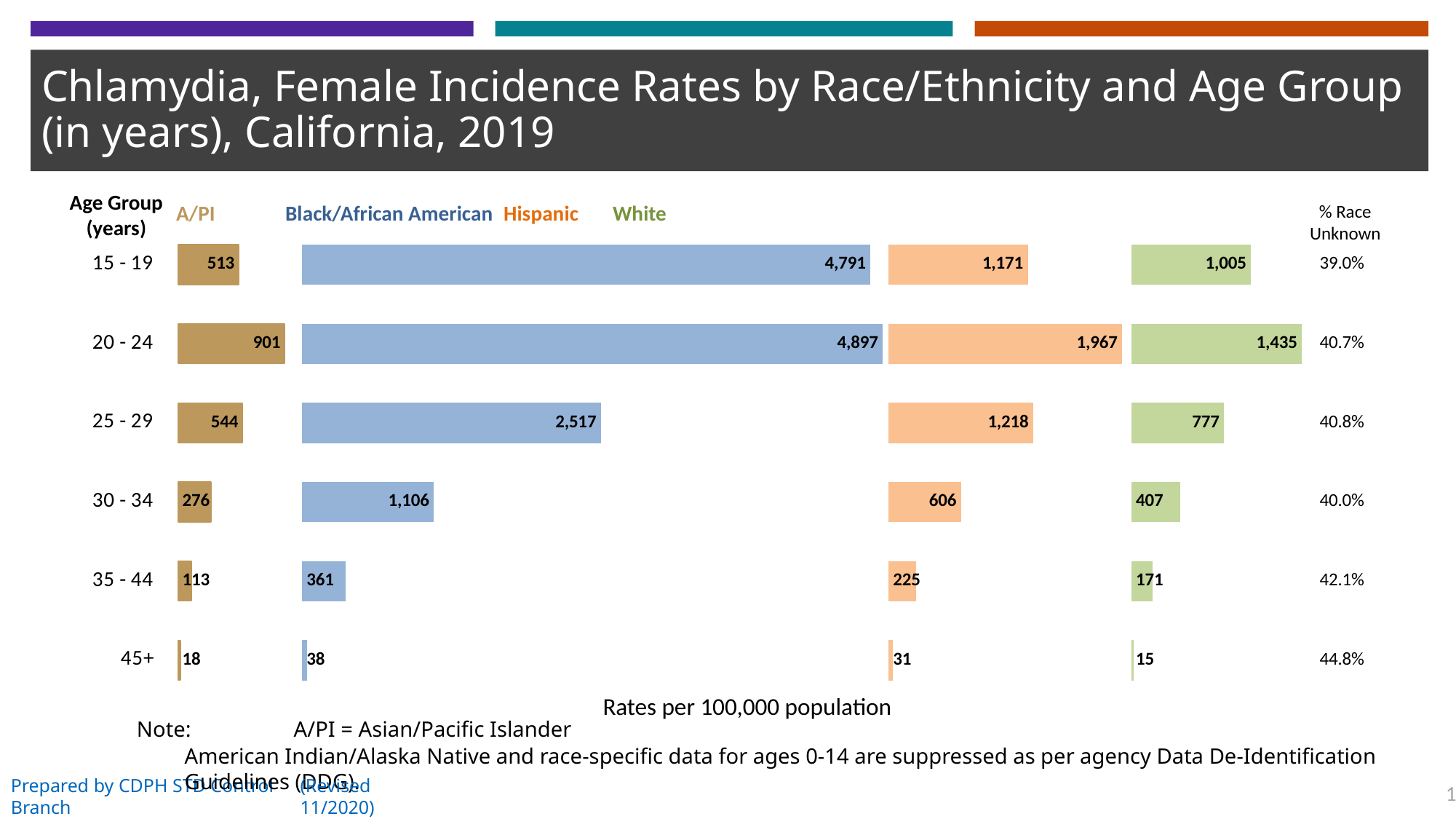
What type of chart is shown on the slide? Bar chart Which is larger for ages 25 - 29: the A/PI rate or the White rate? White What is the difference between the Black/African American and White rates for ages 15 - 19? 3,786 Which age group has the highest rate among Hispanic females? 20 - 24 What is the % Race Unknown value for the 45+ age group? 44.8% What is the rate for A/PI females aged 35 - 44? 113 How many age groups are shown in the chart? 6 How many race/ethnicity series does the chart show? 4 Which race/ethnicity has the lowest rate in the 45+ age group? White What is the rate for Hispanic females aged 25 - 29? 1,218 What is the chlamydia incidence rate for Black/African American females aged 20 - 24? 4,897 What is the rate for White females aged 30 - 34? 407